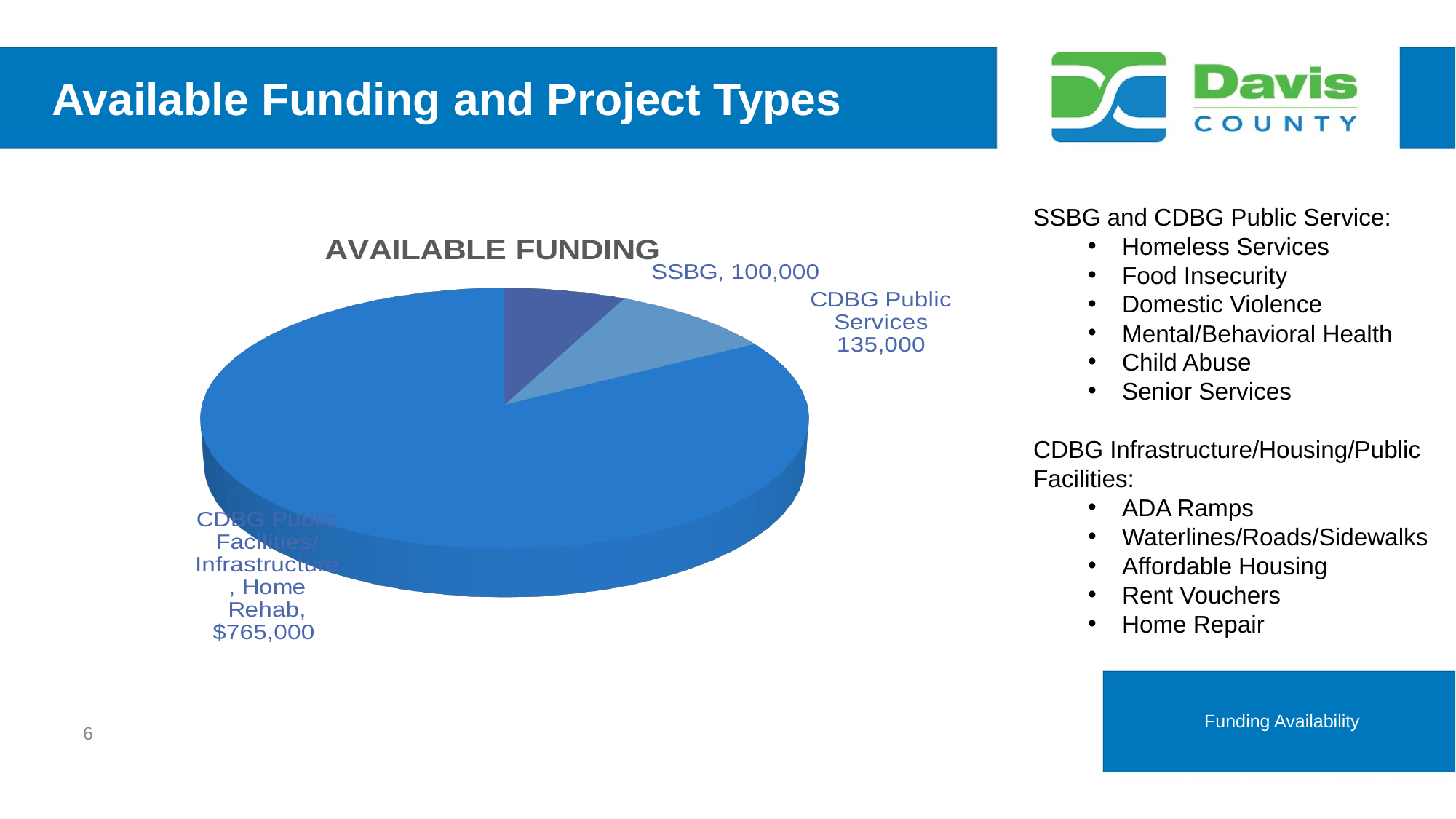
What is the difference between the CDBG Public Services value and the SSBG value? 35,000 What is the title of the chart? AVAILABLE FUNDING How many slices does the pie chart have? 3 What is the value shown for CDBG Public Services? 135,000 What is the value shown for SSBG? 100,000 What type of chart is shown on the slide? Pie chart Which category has the largest slice of the pie? CDBG Public Facilities/Infrastructure, Home Rehab What is the value shown for CDBG Public Facilities/Infrastructure, Home Rehab? $765,000 Which is larger, the value for CDBG Public Services or the value for SSBG? CDBG Public Services What is the total of all three slices in the pie chart? 1,000,000 Which category has the smallest slice of the pie? SSBG